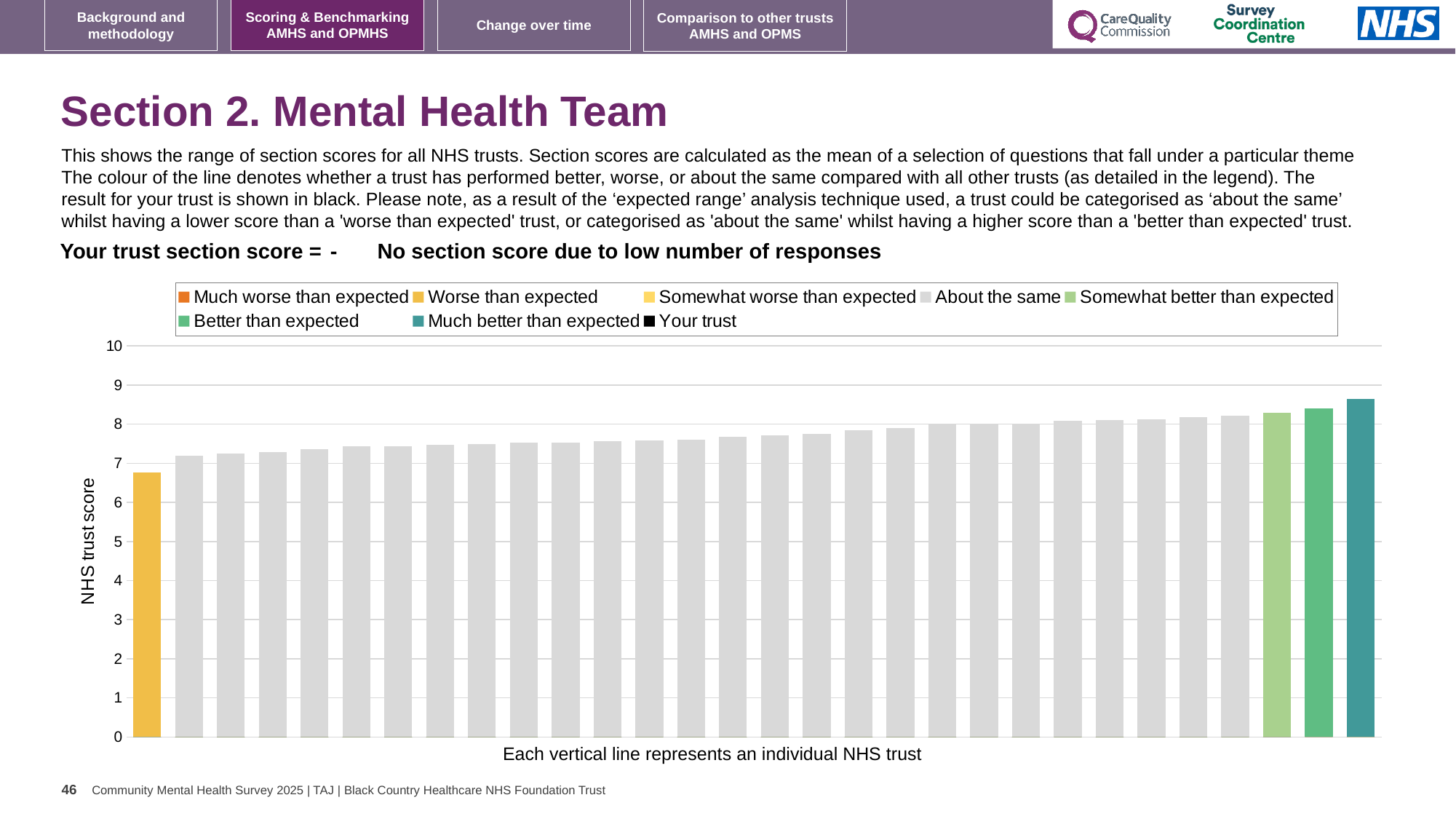
What is the highest value shown on the vertical axis of the chart? 10 What is the label on the vertical axis of the chart? NHS trust score Which legend category does the tallest bar in the chart belong to? Much better than expected Is the value of the 'Worse than expected' bar (the leftmost bar) greater or less than 7? less Is the value of the 'Much better than expected' bar (the rightmost bar) greater or less than 8? greater How many bars in the chart are coloured 'Much better than expected' (teal)? 1 How many bars in the chart are coloured 'Worse than expected' (yellow)? 1 What kind of chart is shown on the slide? bar chart Which legend category does the shortest bar in the chart belong to? Worse than expected Is the value of the 'Somewhat better than expected' bar greater or less than 8? greater How many entries does the chart legend list? 8 Do the bar values rise or fall from left to right along the x axis? rise